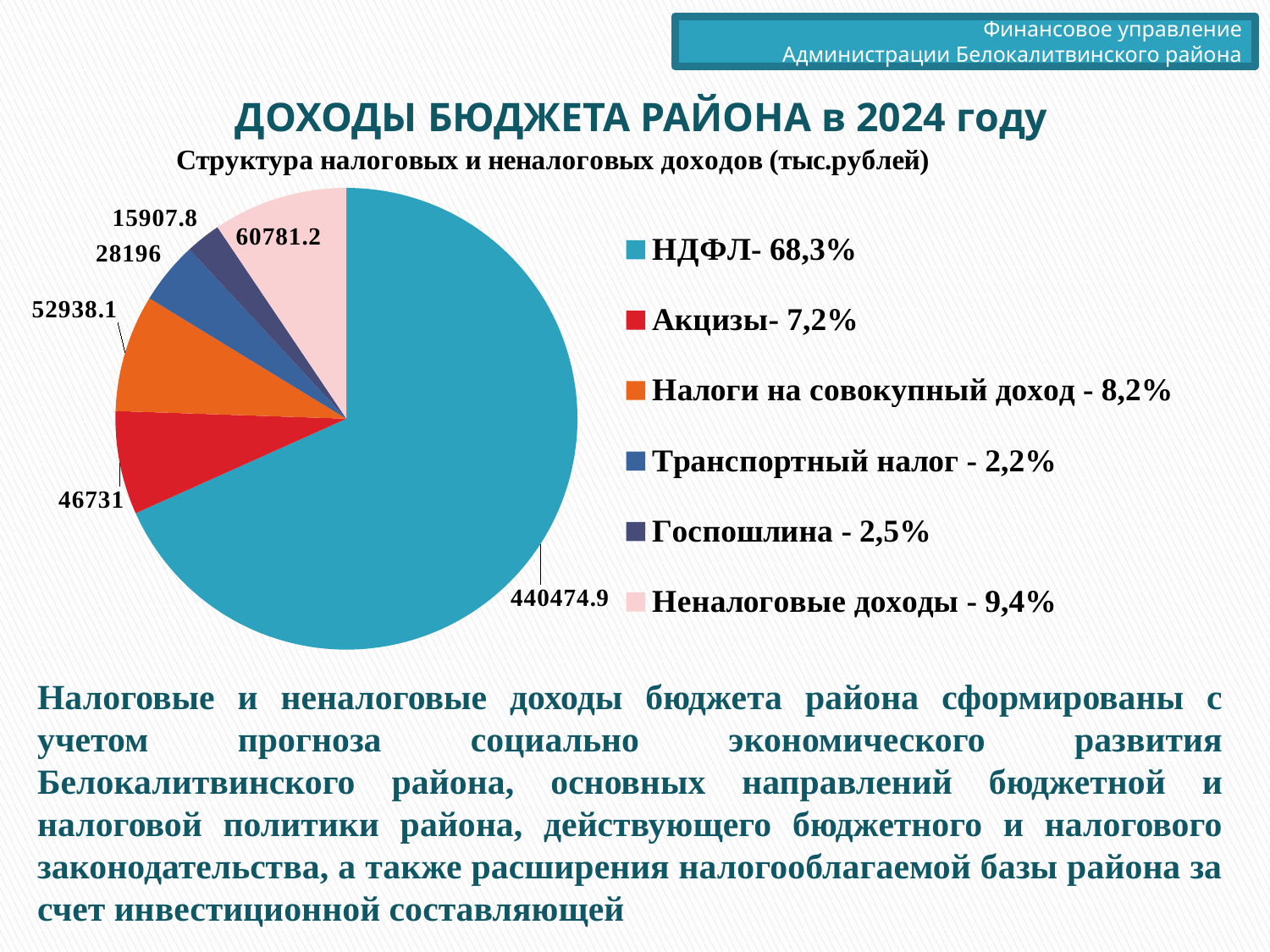
According to the legend, what share of the pie does НДФЛ represent? 68,3% Which category has the largest slice in the pie chart? НДФЛ Which is larger, the value for Налоги на совокупный доход or the value for Акцизы? Налоги на совокупный доход What is the value shown for Акцизы in the pie chart? 46731 Which category has the smallest slice in the pie chart? Госпошлина What is the value shown for НДФЛ in the pie chart? 440474.9 How many slices does the pie chart have? 6 What kind of chart is shown on the slide? pie chart What is the value shown for Налоги на совокупный доход in the pie chart? 52938.1 What is the difference between the values for Неналоговые доходы and Налоги на совокупный доход? 7843.1 What is the value shown for Неналоговые доходы in the pie chart? 60781.2 What is the subtitle of the pie chart? Структура налоговых и неналоговых доходов (тыс.рублей)